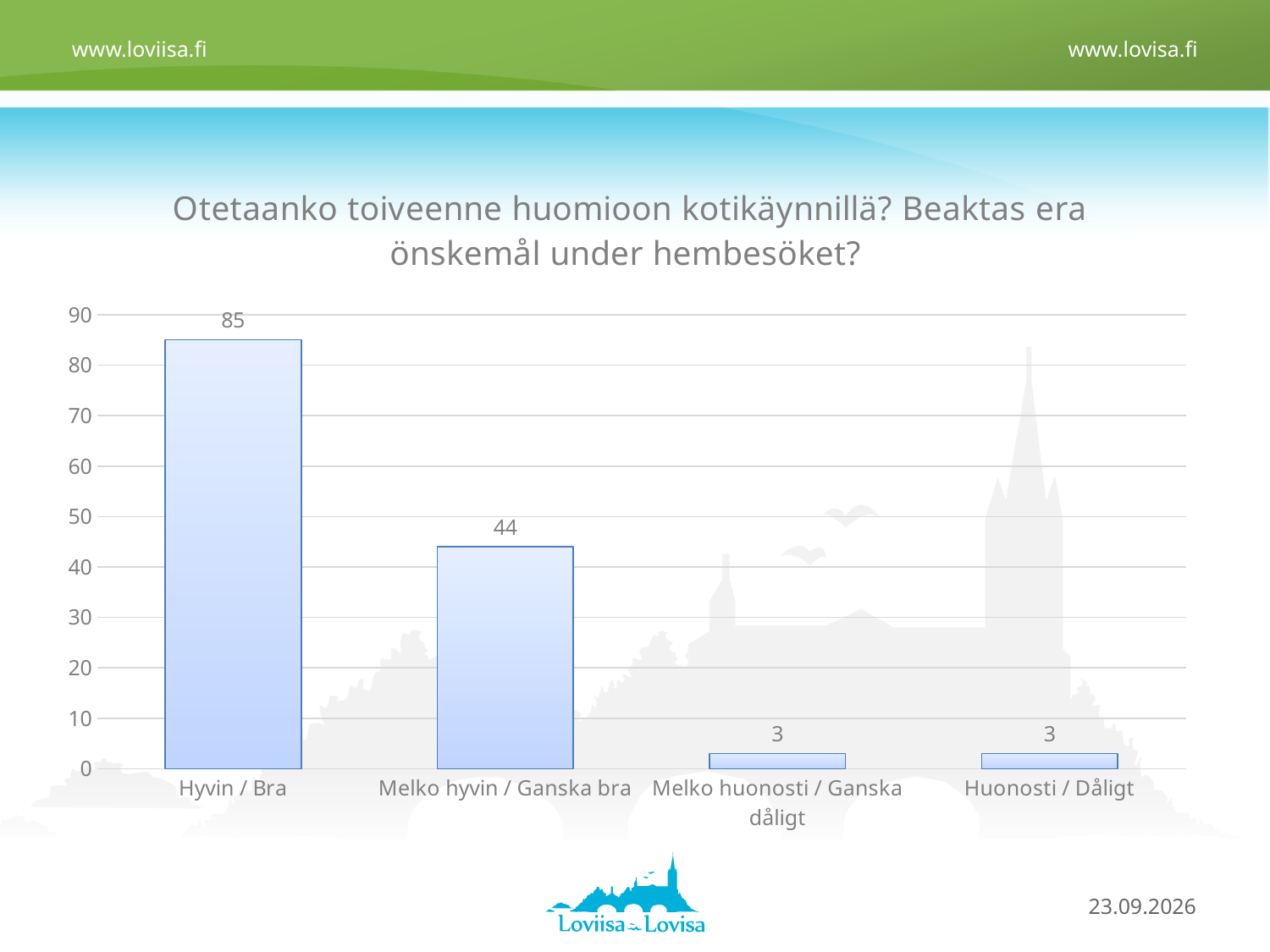
What is the value for Hyvin / Bra? 85 Is the value for Melko hyvin / Ganska bra greater or less than 50? less What is the difference between the values for Hyvin / Bra and Melko hyvin / Ganska bra? 41 What is the total of the values for Melko huonosti / Ganska dåligt and Huonosti / Dåligt? 6 What is the highest value shown on the y axis? 90 Which is larger, the value for Melko hyvin / Ganska bra or the value for Melko huonosti / Ganska dåligt? Melko hyvin / Ganska bra What is the value for Melko hyvin / Ganska bra? 44 Do the values rise or fall from left to right along the x axis? fall What kind of chart is shown on the slide? bar chart What is the value for Huonosti / Dåligt? 3 How many categories are shown on the x axis? 4 Which category has the highest value? Hyvin / Bra